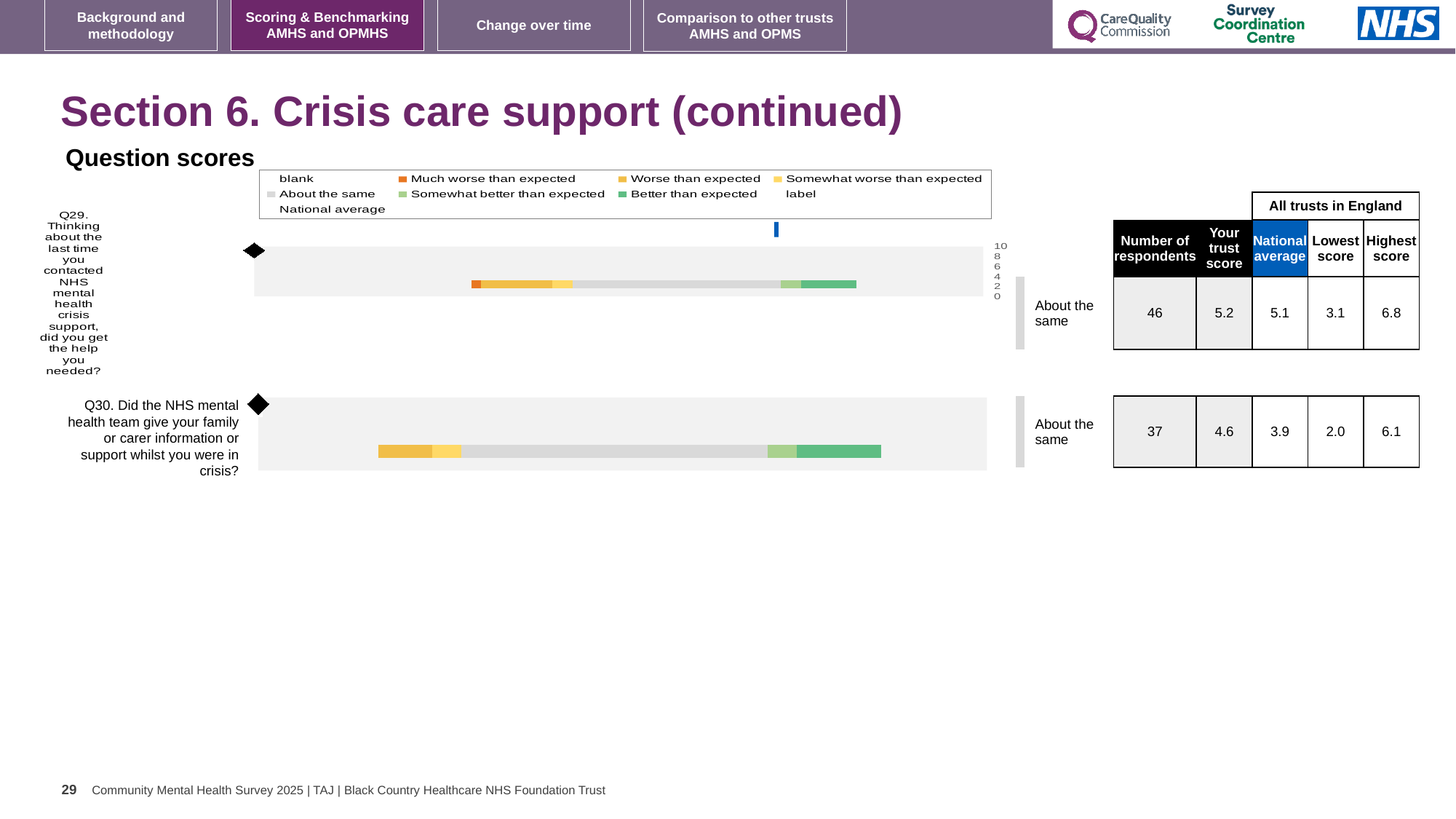
Which benchmark category does the trust fall into for Q30? About the same What is the difference between the highest score and the lowest score for Q29 across all trusts in England? 3.7 What colour represents 'Much worse than expected' in the chart legend? Orange Which benchmark category does the trust fall into for Q29? About the same Is the trust score for Q30 higher or lower than the national average for Q30? Higher What colour represents 'Better than expected' in the chart legend? Green What kind of chart is used to show the question scores for Q29 and Q30? Bar chart How many questions (bars) are plotted in the question scores chart? 2 How many respondents answered Q30? 37 What is the difference between the trust score and the national average for Q30? 0.7 What is the national average for Q30 shown in the table next to the chart? 3.9 What is the trust score for Q29 shown in the table next to the chart? 5.2